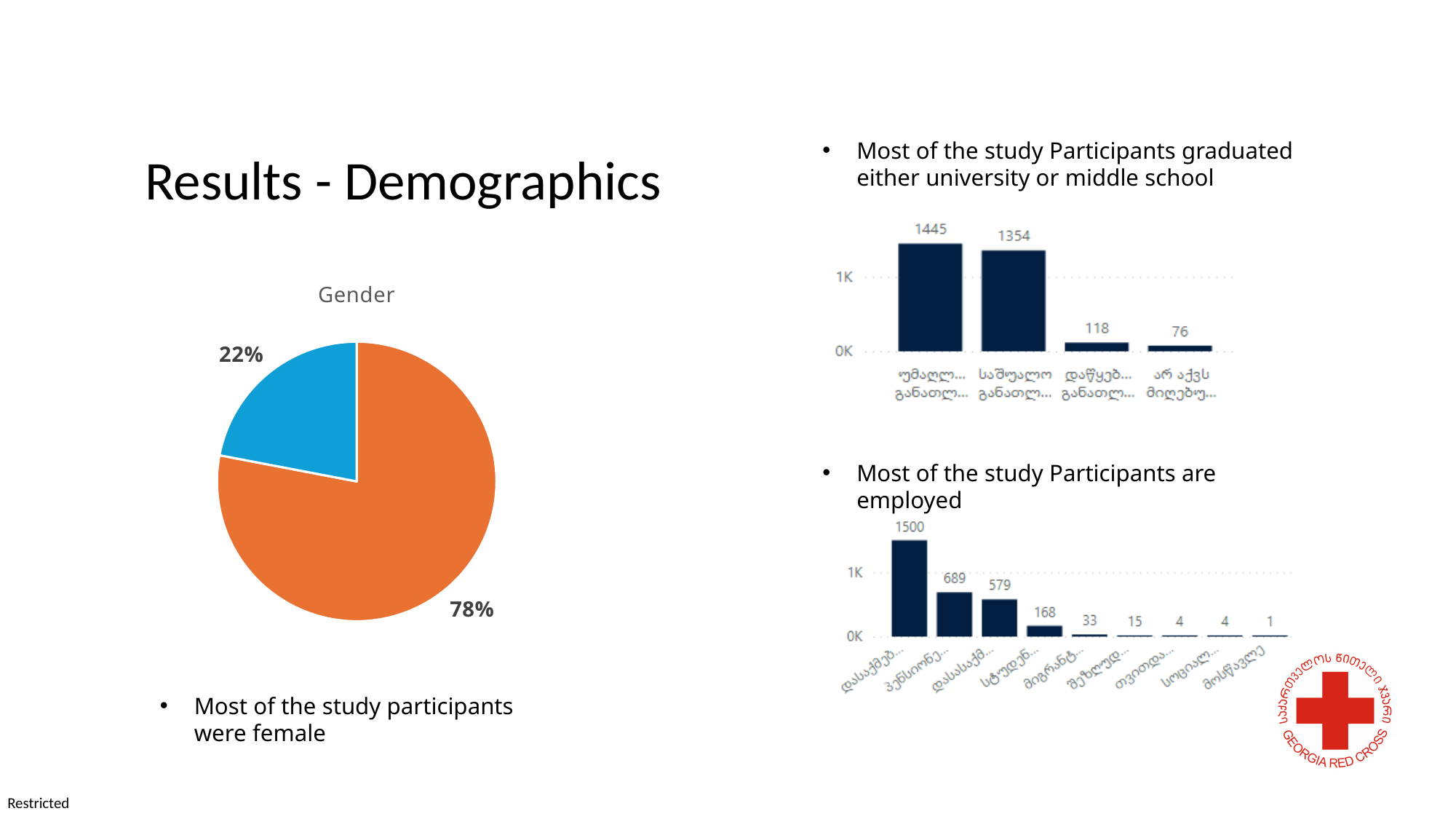
In the employment bar chart at the bottom right, what is the value of the tallest bar? 1500 In the education bar chart at the top right, what is the difference between the first and second bars? 91 In the education bar chart at the top right, what is the value of the shortest bar? 76 In the Gender pie chart, what share does the orange slice represent? 78% How many bars does the employment bar chart at the bottom right have? 9 In the education bar chart at the top right, what is the value of the tallest bar? 1445 What kind of chart is the education chart at the top right of the slide? bar chart In the Gender pie chart, what is the difference between the two slices' percentages? 56% How many bars does the education bar chart at the top right have? 4 How many slices does the Gender pie chart have? 2 What kind of chart is the Gender chart? pie chart In the Gender pie chart, what share does the blue slice represent? 22%